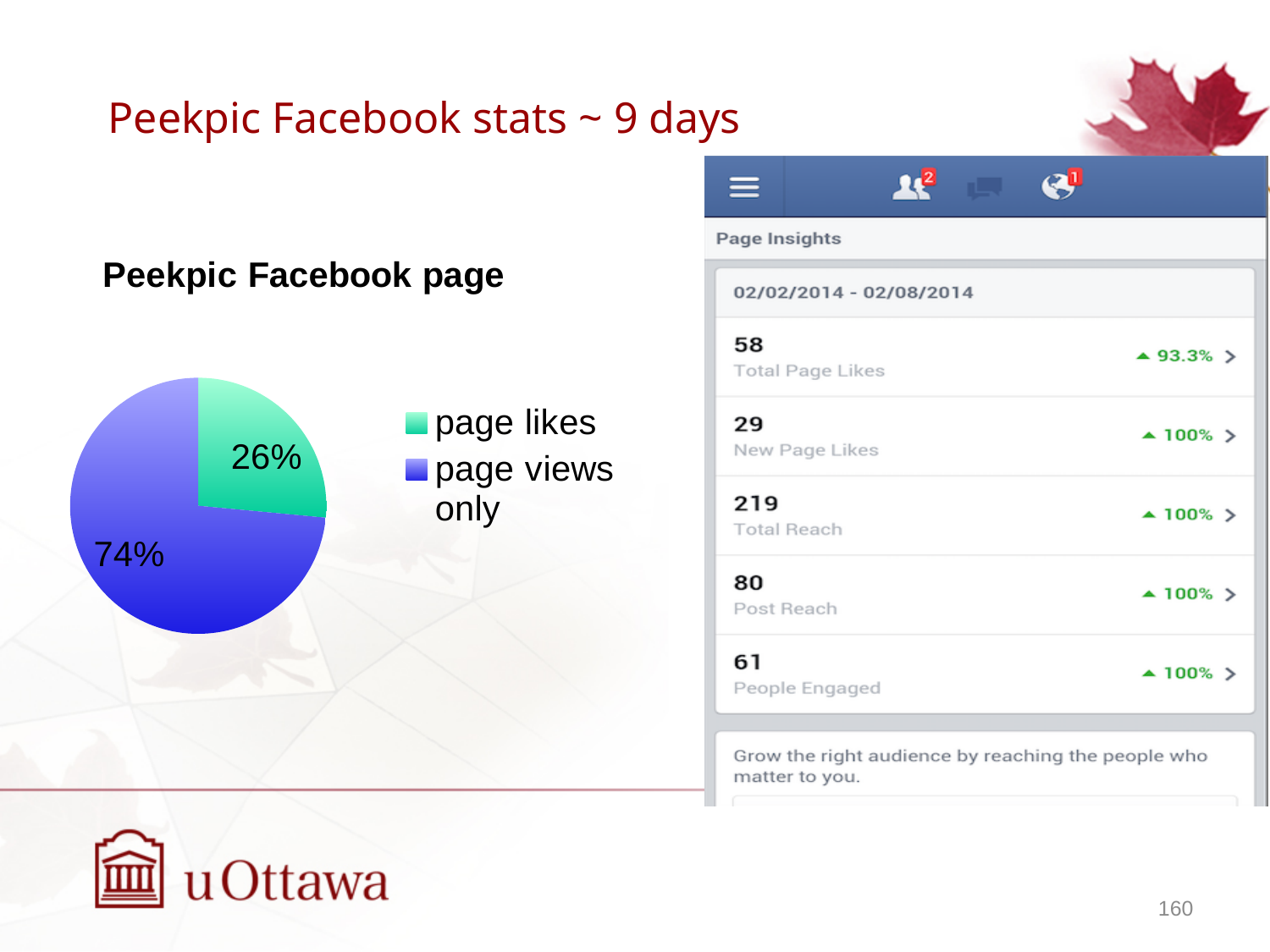
What is the difference in percentage points between the page views only slice and the page likes slice? 48 Which is larger in the pie chart: page likes or page views only? page views only What share of the pie does "page likes" represent? 26% Which slice of the pie chart is the smallest? page likes What kind of chart is shown on the slide? pie chart What colour is the "page views only" slice in the pie chart? blue How many entries does the pie chart's legend list? 2 How many slices does the pie chart have? 2 Which slice of the pie chart is the largest? page views only What is the title of the pie chart? Peekpic Facebook page What share of the pie does "page views only" represent? 74%